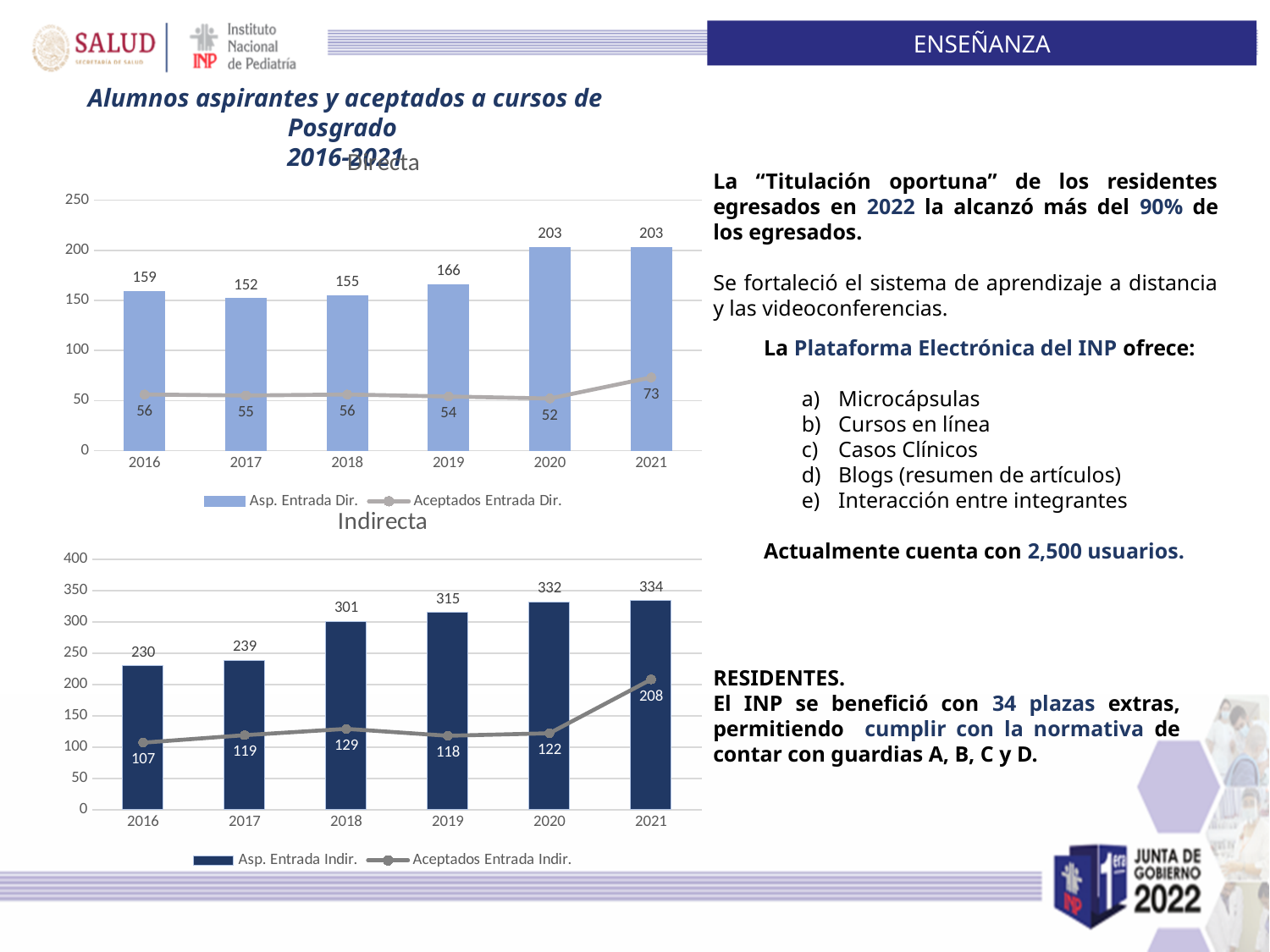
In the Indirecta chart, how many years are shown on the x axis? 6 In the Directa chart, how many series does the legend list? 2 In the Indirecta chart, what is the difference between Asp. Entrada Indir. in 2021 and in 2016? 104 In the Indirecta chart, is the value of Aceptados Entrada Indir. for 2021 larger or smaller than for 2020? larger In the Indirecta chart, what is the value of Aceptados Entrada Indir. for 2016? 107 In the Indirecta chart, which year has the highest value for Asp. Entrada Indir.? 2021 In the Directa chart, what is the difference between Asp. Entrada Dir. and Aceptados Entrada Dir. in 2020? 151 In the Directa chart, which year has the lowest value for Aceptados Entrada Dir.? 2020 In the Directa chart, what is the value of Asp. Entrada Dir. for 2019? 166 In the Indirecta chart, do the values of Asp. Entrada Indir. rise or fall from 2016 to 2021? rise In the Indirecta chart, what is the value of Asp. Entrada Indir. for 2018? 301 In the Directa chart, what is the value of Aceptados Entrada Dir. for 2021? 73